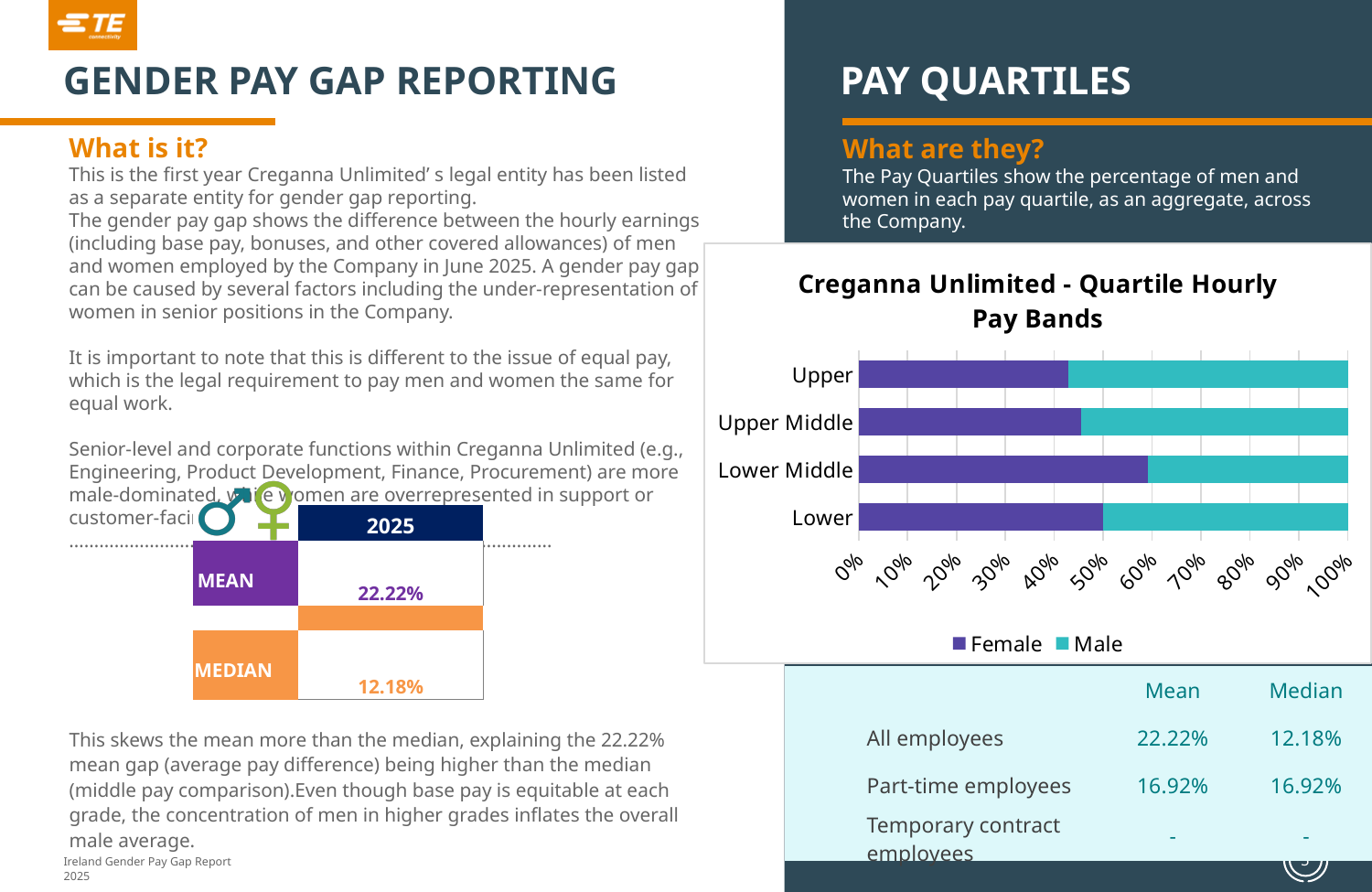
In the 'Quartile Hourly Pay Bands' chart, is the Male share larger for Upper or for Lower Middle? Upper In the 'Quartile Hourly Pay Bands' chart, is the Female share for Upper greater or less than 50%? less What are the two series named in the legend of the 'Quartile Hourly Pay Bands' chart? Female and Male What is the title of the bar chart on the slide? Creganna Unlimited - Quartile Hourly Pay Bands In the 'Quartile Hourly Pay Bands' chart, is the Female share for Upper Middle greater or less than 50%? less In the 'Quartile Hourly Pay Bands' chart, which quartile has the largest Female share? Lower Middle What kind of chart is 'Creganna Unlimited - Quartile Hourly Pay Bands'? Stacked bar chart In the 'Quartile Hourly Pay Bands' chart, is the Male share for Upper greater or less than 50%? greater How many pay quartile categories are shown on the 'Quartile Hourly Pay Bands' chart? 4 In the 'Quartile Hourly Pay Bands' chart, is the Female share larger for Lower Middle or for Upper? Lower Middle How many series does the legend of the 'Quartile Hourly Pay Bands' chart list? 2